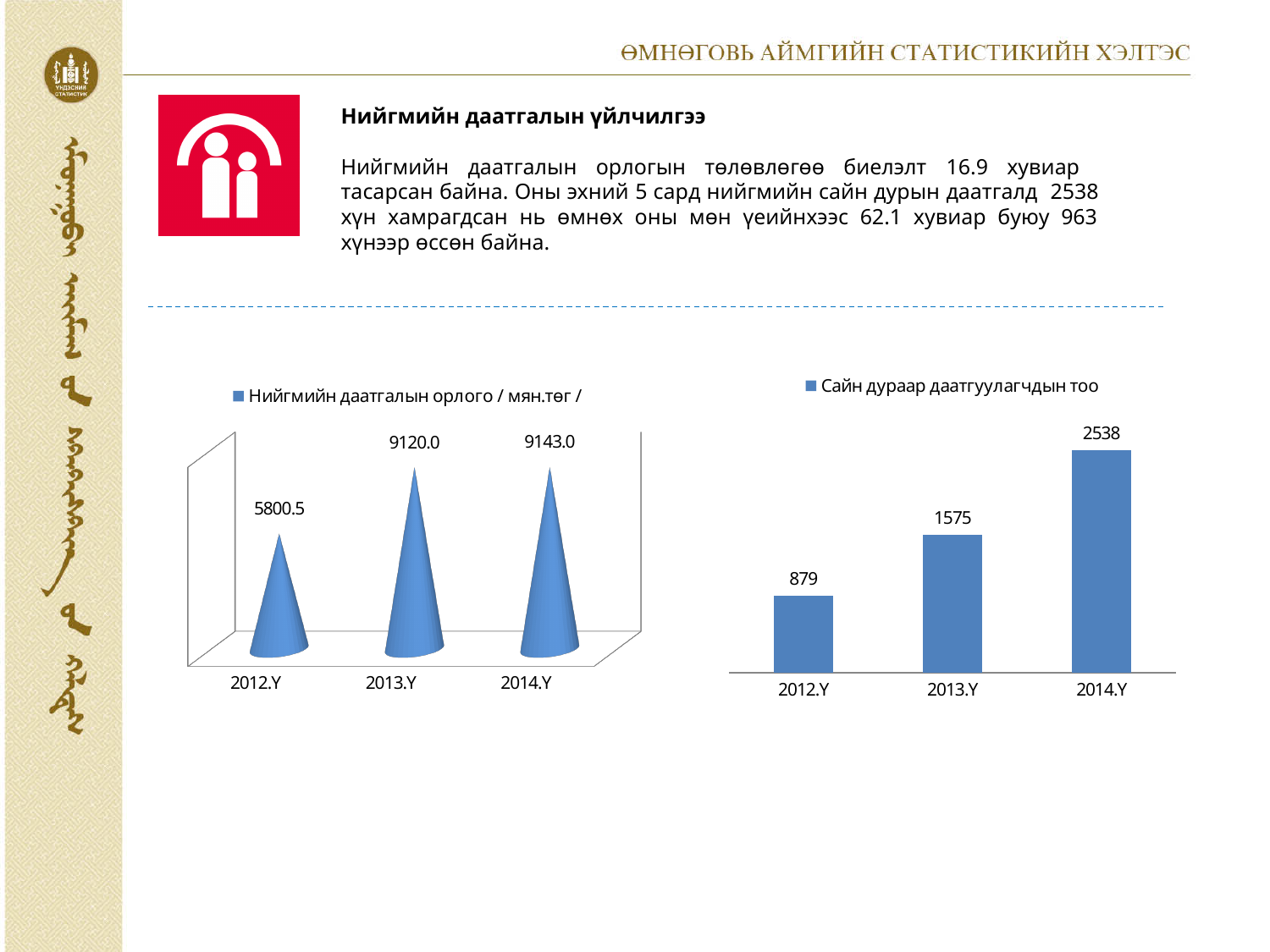
In the left chart (Нийгмийн даатгалын орлого / мян.төг /), what is the difference between the values for 2013.Y and 2012.Y? 3319.5 In the right chart (Сайн дураар даатгуулагчдын тоо), what is the value for 2013.Y? 1575 In the right chart (Сайн дураар даатгуулагчдын тоо), do the values rise or fall from 2012.Y to 2014.Y? rise In the left chart (Нийгмийн даатгалын орлого / мян.төг /), how many years are shown on the x axis? 3 In the right chart (Сайн дураар даатгуулагчдын тоо), what is the value for 2012.Y? 879 How many series does the legend of the left chart list? 1 In the right chart (Сайн дураар даатгуулагчдын тоо), what is the difference between the values for 2014.Y and 2013.Y? 963 In the left chart (Нийгмийн даатгалын орлого / мян.төг /), what is the value for 2012.Y? 5800.5 What kind of chart is the right chart (Сайн дураар даатгуулагчдын тоо)? bar chart In the left chart (Нийгмийн даатгалын орлого / мян.төг /), what is the value for 2014.Y? 9143.0 In the right chart (Сайн дураар даатгуулагчдын тоо), which year has the highest value? 2014.Y In the left chart (Нийгмийн даатгалын орлого / мян.төг /), which year has the lowest value? 2012.Y